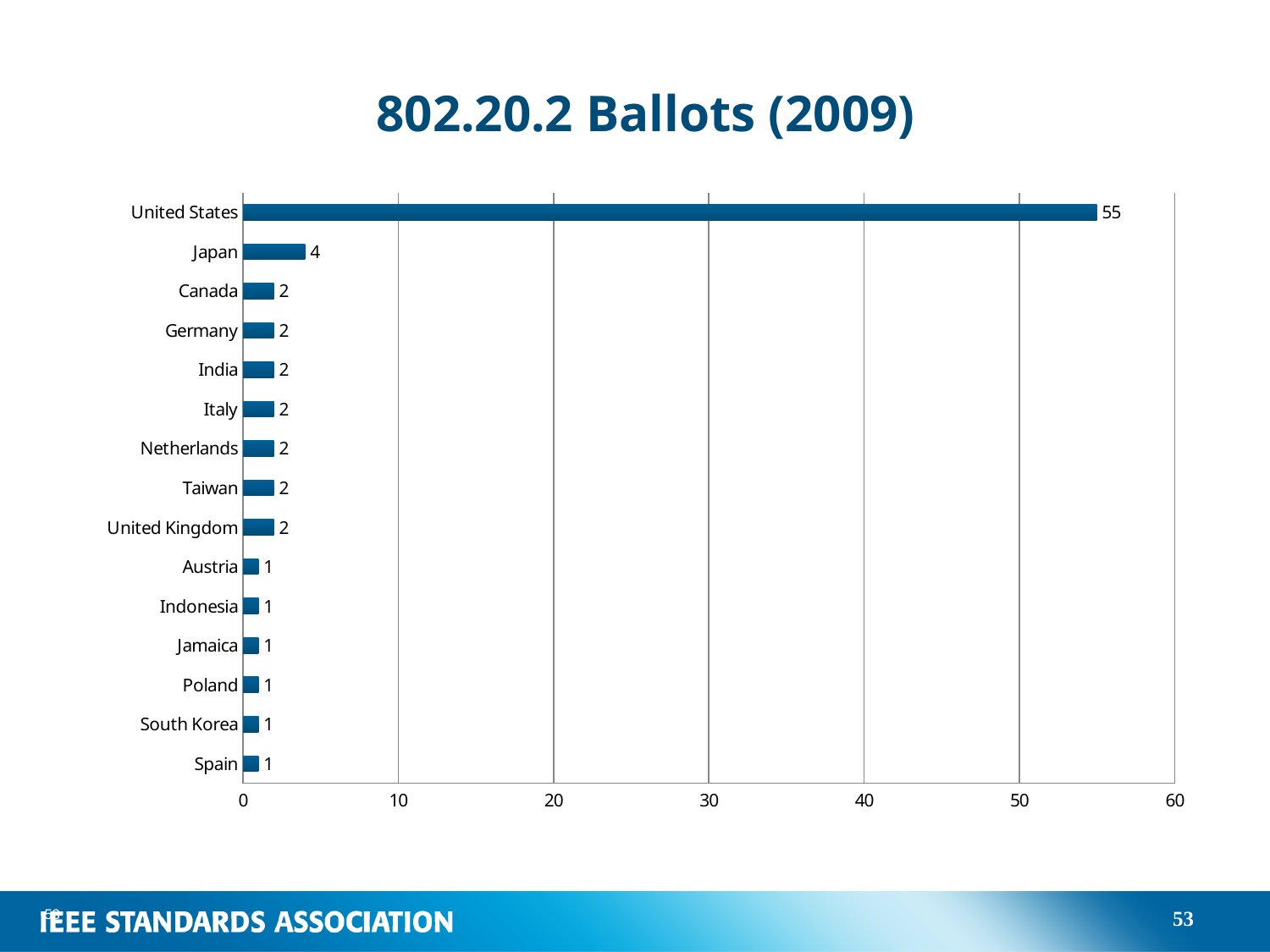
Which is larger, the value for Japan or the value for Germany? Japan What is the value for South Korea? 1 What is the value for Japan? 4 What kind of chart is shown on the slide? bar chart What is the value for United States? 55 How many countries are shown in the chart? 15 What is the difference between the values for Japan and Canada? 2 What is the title of the chart? 802.20.2 Ballots (2009) What is the difference between the values for United States and Japan? 51 Is the value for United States greater or less than 50? greater Which country has the highest value? United States What is the value for Netherlands? 2